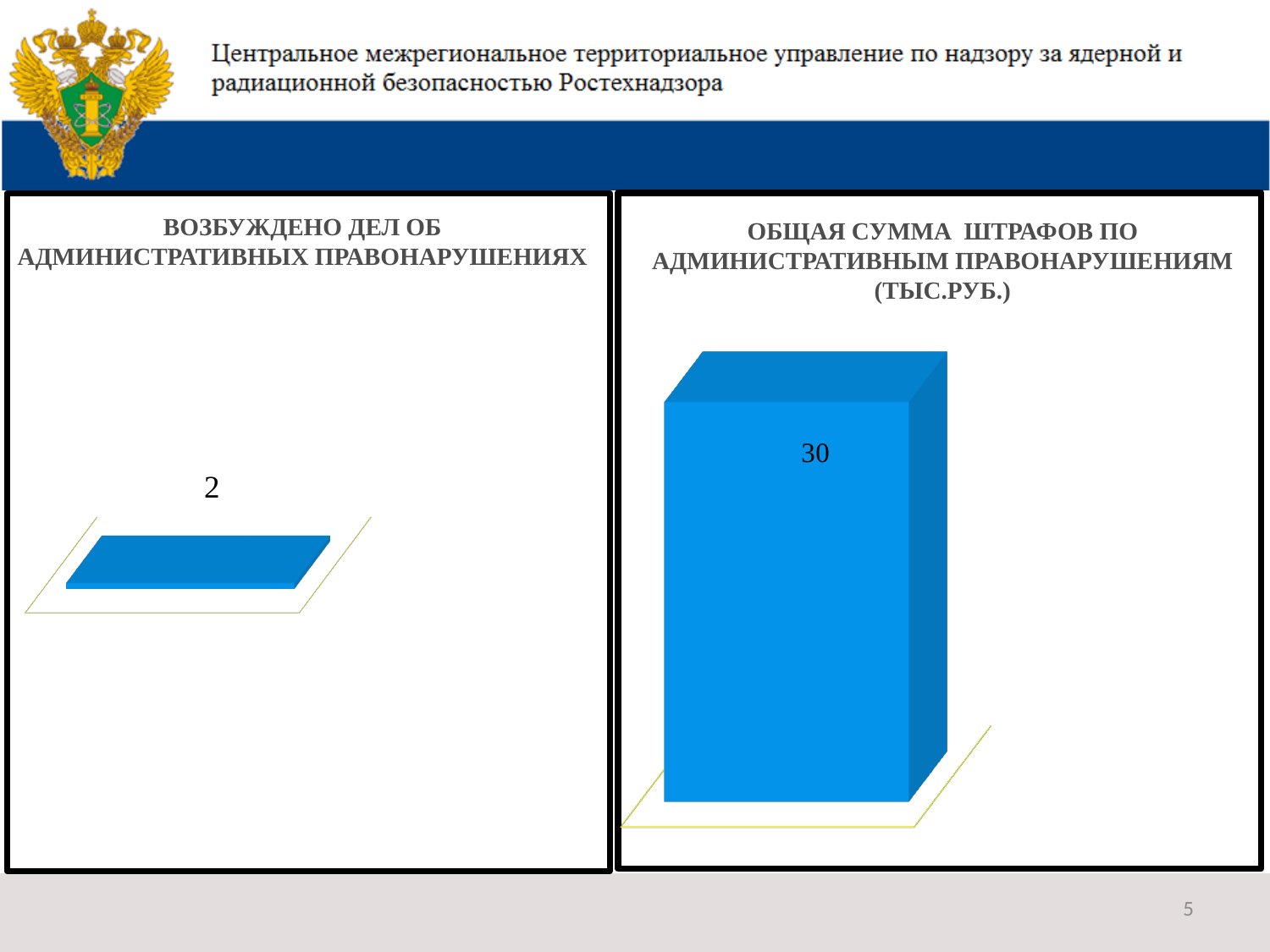
What kind of chart is the right chart? Bar chart How many charts are shown on the slide? 2 What kind of chart is the left chart? Bar chart How many bars are plotted on the right chart? 1 On the right chart ("ОБЩАЯ СУММА ШТРАФОВ ПО АДМИНИСТРАТИВНЫМ ПРАВОНАРУШЕНИЯМ (ТЫС.РУБ.)"), what value is shown on the bar? 30 What unit is given in the title of the right chart? ТЫС.РУБ. What is the title of the left chart? ВОЗБУЖДЕНО ДЕЛ ОБ АДМИНИСТРАТИВНЫХ ПРАВОНАРУШЕНИЯХ On the left chart ("ВОЗБУЖДЕНО ДЕЛ ОБ АДМИНИСТРАТИВНЫХ ПРАВОНАРУШЕНИЯХ"), what value is shown on the bar? 2 How many bars are plotted on the left chart? 1